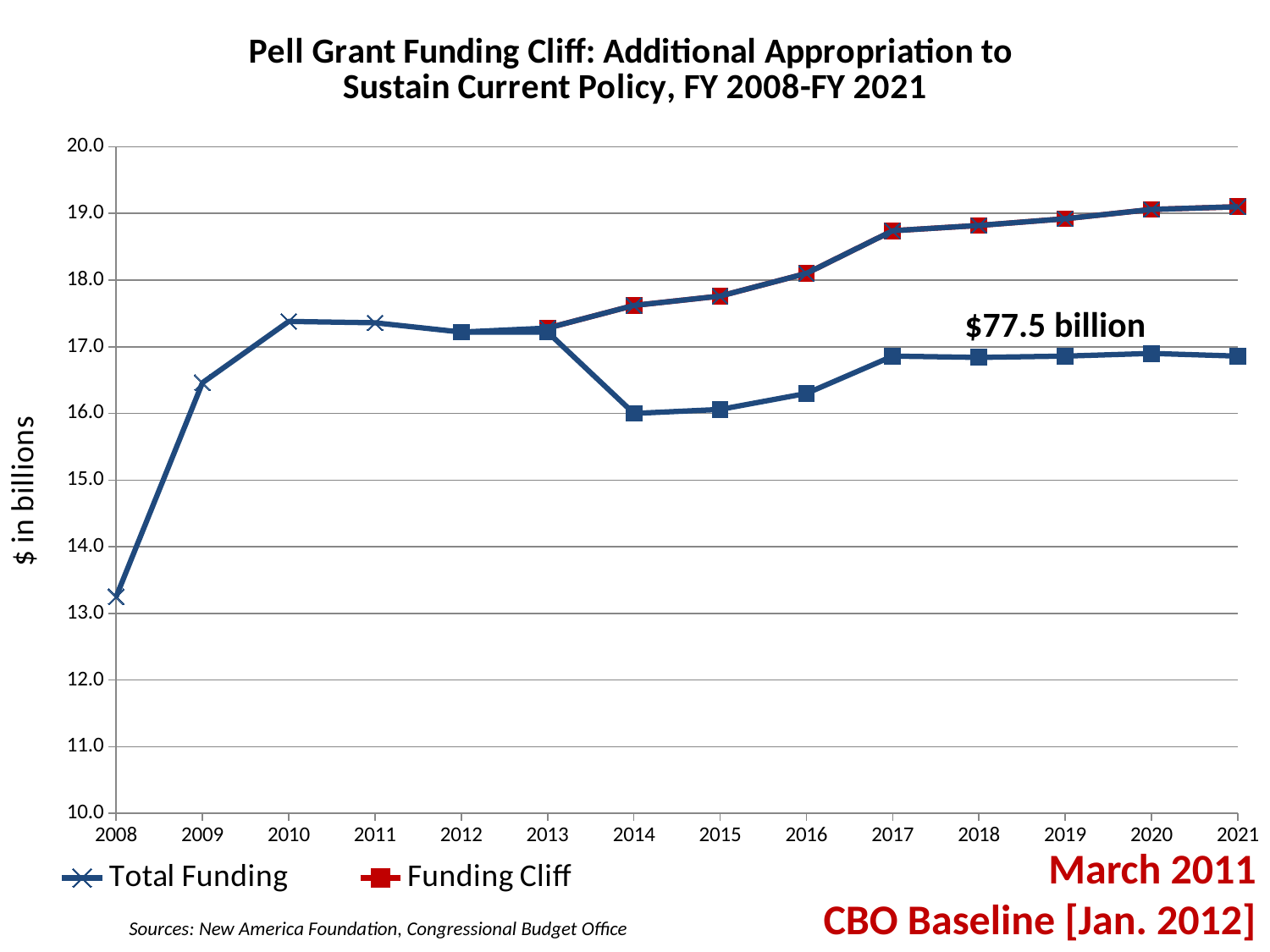
Is the Funding Cliff value for 2014 greater or less than 17.0? greater Does the Total Funding line rise or fall from 2008 to 2010? rise Which year has the lowest Total Funding value? 2008 How many years are shown along the x axis? 14 What kind of chart is shown on the slide? line chart Is the Total Funding value for 2008 greater or less than 14.0? less How many series does the legend list? 2 Is the Total Funding value for 2009 greater or less than 16.0? greater Does the Funding Cliff line rise or fall from 2013 to 2021? rise What dollar amount is annotated on the chart near the lower line? $77.5 billion